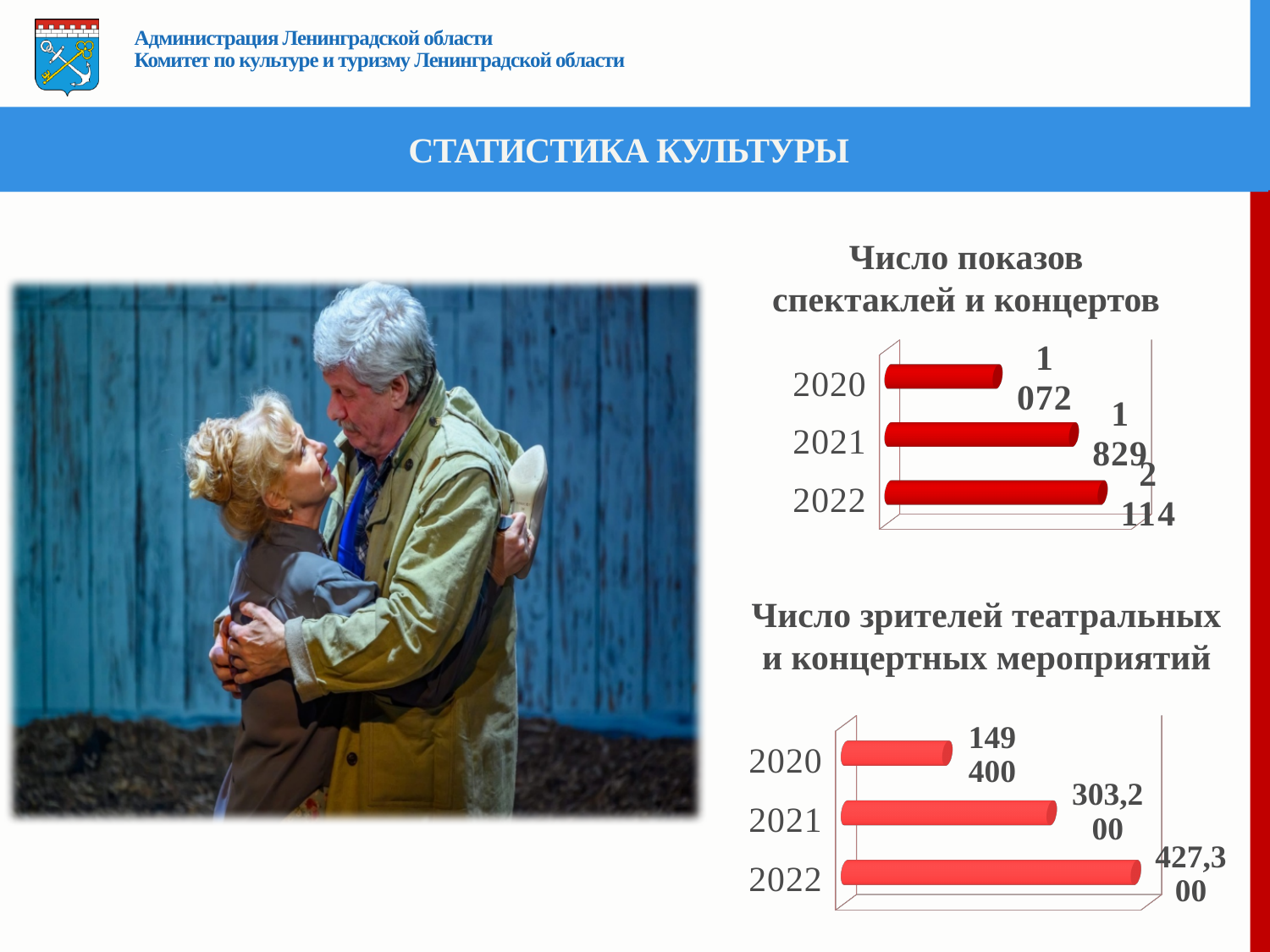
In the chart 'Число показов спектаклей и концертов', which year has the lowest value? 2020 In the chart 'Число зрителей театральных и концертных мероприятий', what is the value for 2021? 303,200 In the chart 'Число зрителей театральных и концертных мероприятий', how many years are shown? 3 In the chart 'Число показов спектаклей и концертов', do the values rise or fall from 2020 to 2022? rise In the chart 'Число показов спектаклей и концертов', what is the value for 2020? 1 072 In the chart 'Число зрителей театральных и концертных мероприятий', what is the difference between the values for 2022 and 2020? 277,900 In the chart 'Число показов спектаклей и концертов', what is the value for 2022? 2 114 In the chart 'Число зрителей театральных и концертных мероприятий', which year has the lowest value? 2020 In the chart 'Число зрителей театральных и концертных мероприятий', what is the value for 2022? 427,300 In the chart 'Число показов спектаклей и концертов', what is the difference between the values for 2022 and 2021? 285 In the chart 'Число показов спектаклей и концертов', which year has the highest value? 2022 What kind of chart is 'Число зрителей театральных и концертных мероприятий'? bar chart